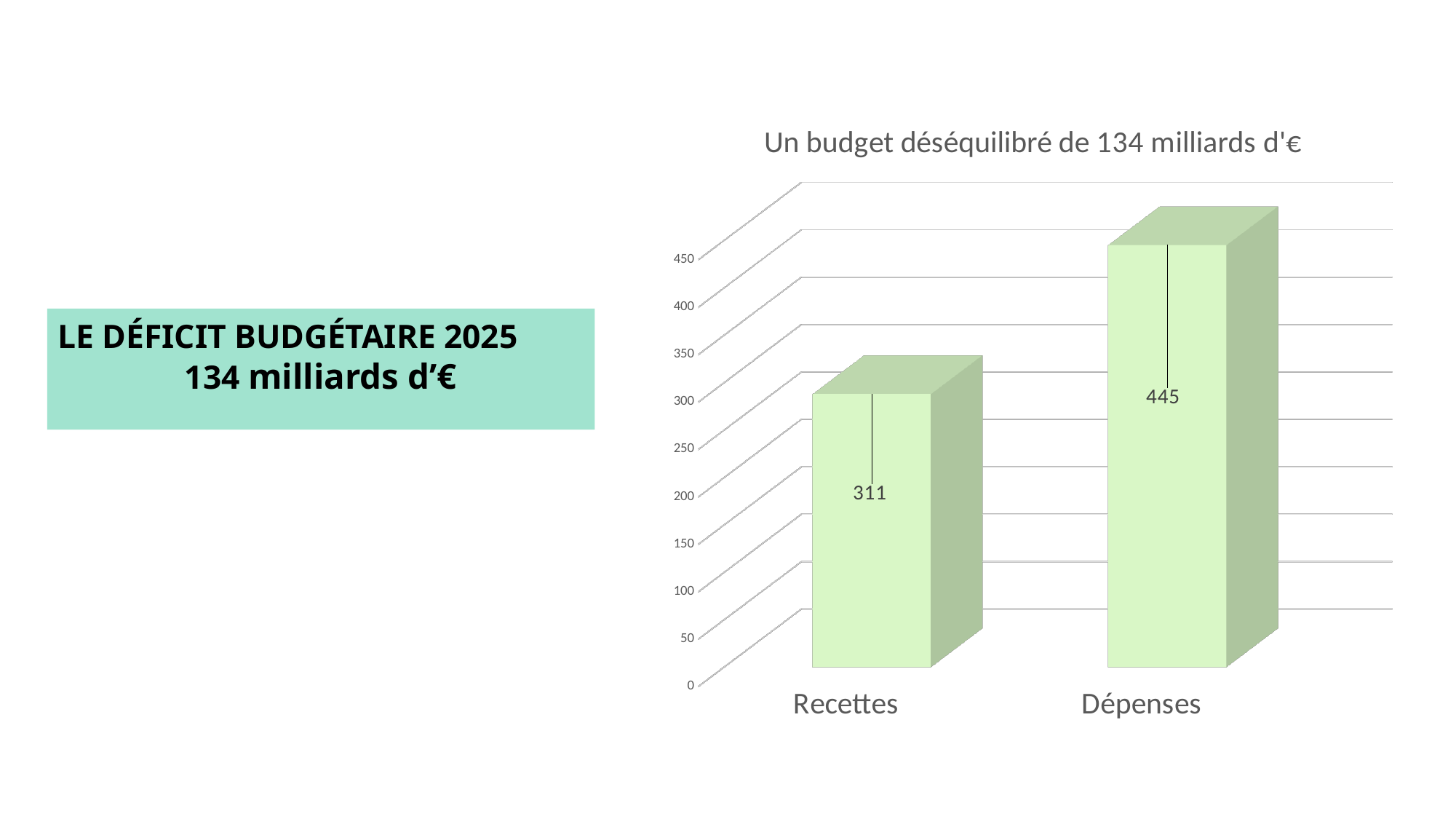
Which is larger, the value for Recettes or the value for Dépenses? Dépenses What is the title of the chart? Un budget déséquilibré de 134 milliards d'€ How many categories are shown on the chart? 2 What is the highest value labelled on the vertical axis? 450 Is the value for Dépenses greater or less than 400? greater What is the value for Recettes? 311 Which category has the highest value? Dépenses Which category has the lowest value? Recettes Is the value for Recettes greater or less than 350? less What kind of chart is shown on the slide? bar chart What is the difference between the values for Dépenses and Recettes? 134 What is the value for Dépenses? 445